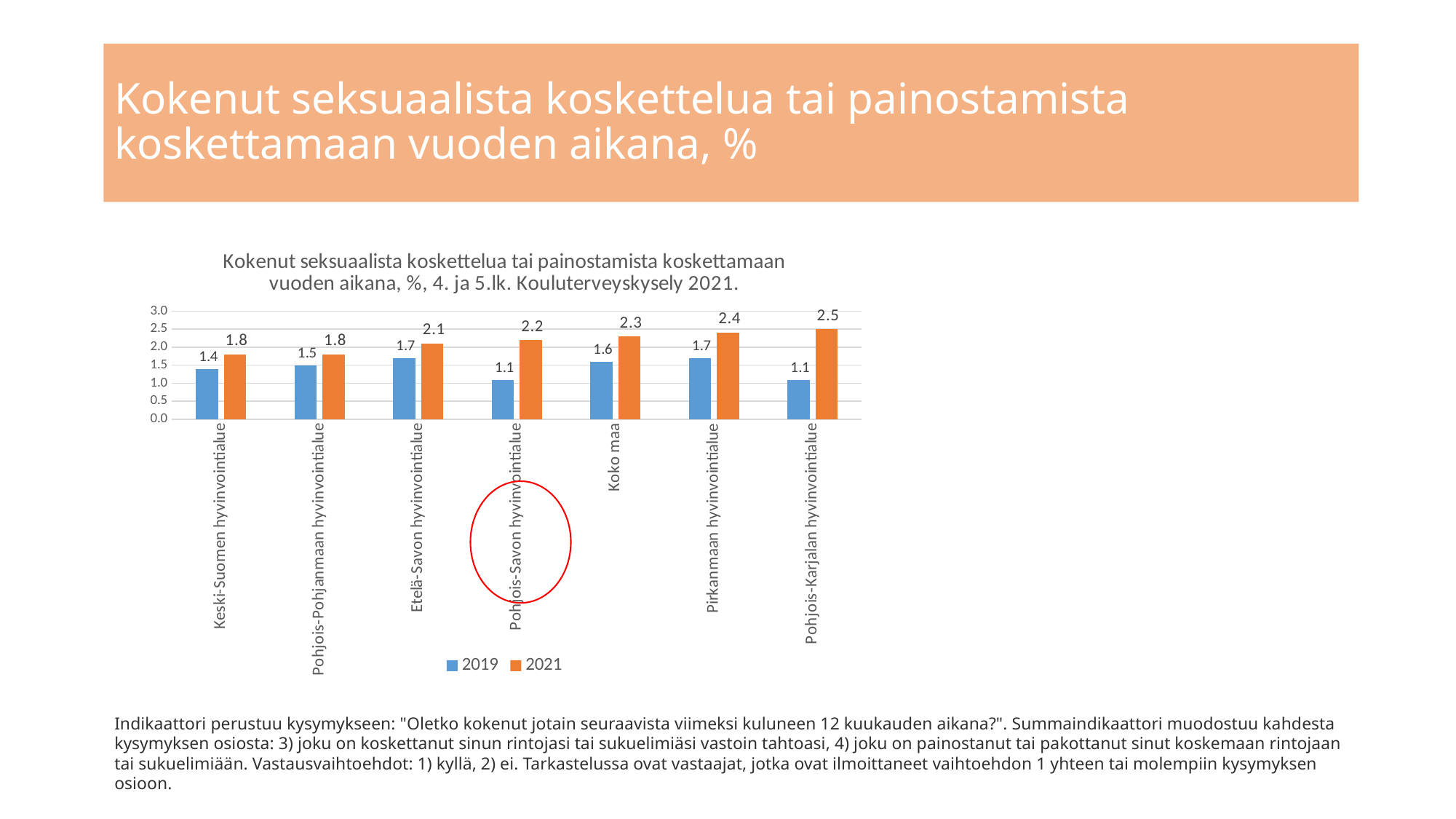
Which category has the highest 2021 value? Pohjois-Karjalan hyvinvointialue What is the 2019 value for Etelä-Savon hyvinvointialue? 1.7 What is the difference between the 2021 and 2019 values for Pohjois-Savon hyvinvointialue? 1.1 Is the 2021 value for Pohjois-Karjalan hyvinvointialue greater or less than 2.0? greater Which category has the lowest 2021 value? Keski-Suomen hyvinvointialue and Pohjois-Pohjanmaan hyvinvointialue (both 1.8) Which series is shown in orange? 2021 What kind of chart is shown on the slide? Bar chart What is the 2021 value for Pohjois-Savon hyvinvointialue? 2.2 How many categories are shown on the x axis? 7 Which is larger for Pirkanmaan hyvinvointialue, the 2019 value or the 2021 value? 2021 How many series does the legend list? 2 What is the 2019 value for Koko maa? 1.6